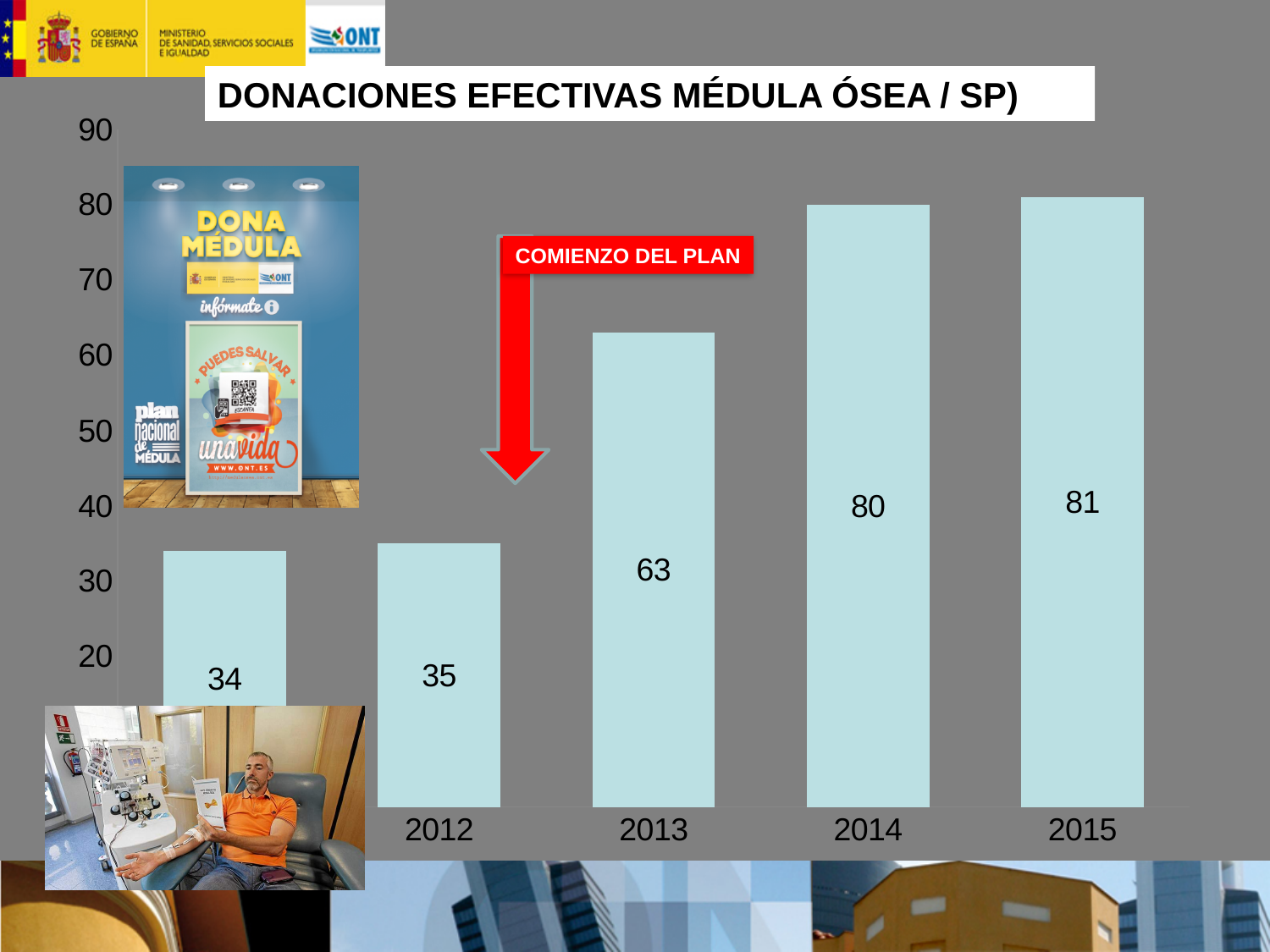
What is the value for 2015? 81 What is the difference between the values for 2014 and 2012? 45 Which is larger, the value for 2013 or the value for 2014? 2014 What is the value for 2014? 80 Which year has the highest value? 2015 Do the values rise or fall from 2012 to 2015? rise How many bars are plotted in the chart? 5 Is the value for 2013 greater or less than 60? greater What is the value for 2012? 35 What is the value for 2013? 63 What is the difference between the values for 2013 and 2012? 28 What kind of chart is shown on the slide? bar chart